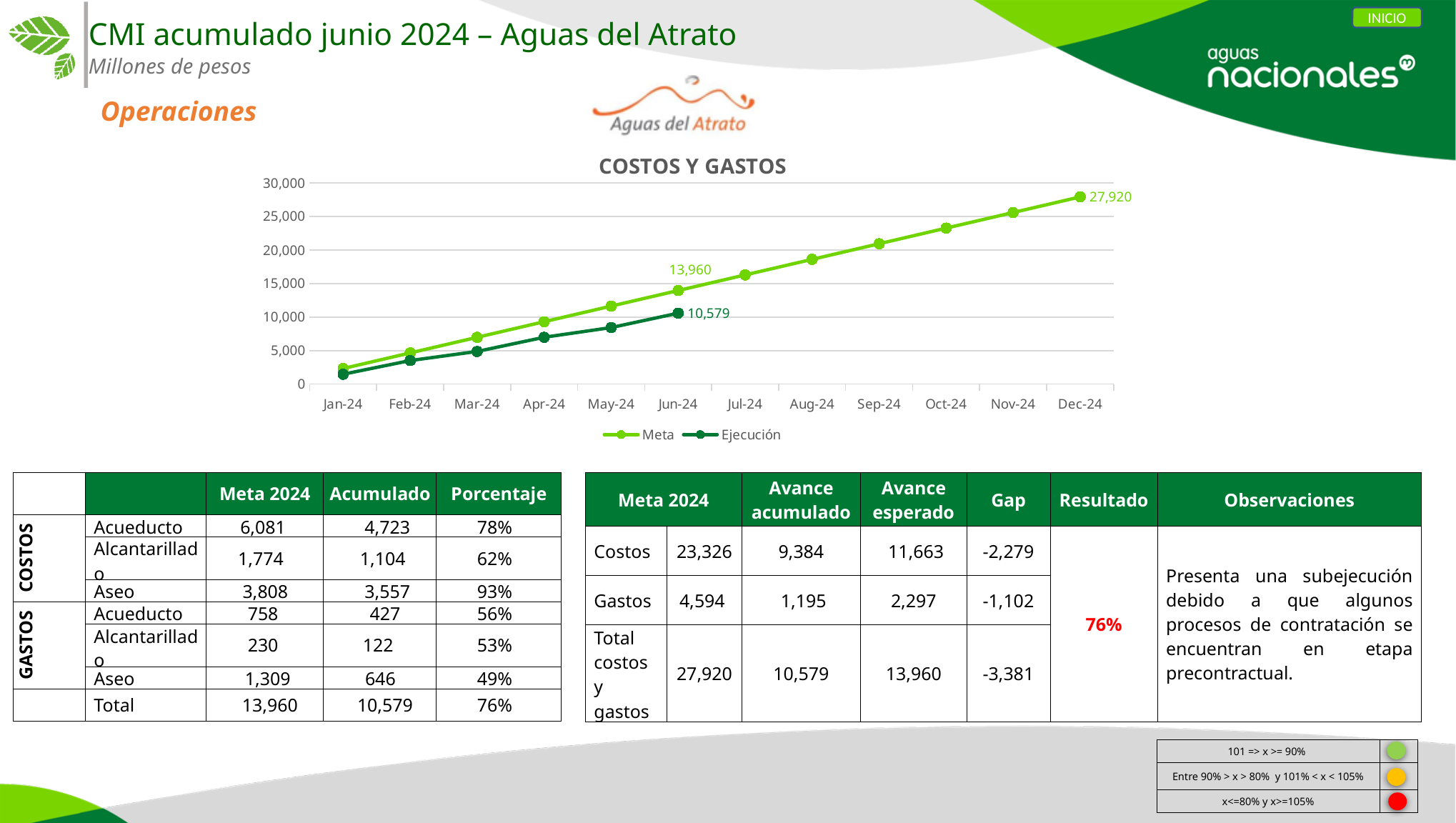
What are the two legend entries of the COSTOS Y GASTOS chart? Meta and Ejecución How many series does the legend of the COSTOS Y GASTOS chart list? 2 In the COSTOS Y GASTOS chart, which series has the larger value at Jun-24, Meta or Ejecución? Meta Does the Meta series in the COSTOS Y GASTOS chart rise or fall from Jan-24 to Dec-24? Rise In the COSTOS Y GASTOS chart, is the Ejecución value for May-24 greater or less than 10,000? less What is the Meta value for Jun-24 in the COSTOS Y GASTOS chart? 13,960 What is the Ejecución value for Jun-24 in the COSTOS Y GASTOS chart? 10,579 In the COSTOS Y GASTOS chart, what is the difference between the Meta and Ejecución values for Jun-24? 3,381 How many months are shown on the x axis of the COSTOS Y GASTOS chart? 12 In the COSTOS Y GASTOS chart, is the Meta value for Mar-24 greater or less than 5,000? greater What is the Meta value for Dec-24 in the COSTOS Y GASTOS chart? 27,920 What kind of chart is the COSTOS Y GASTOS chart? Line chart